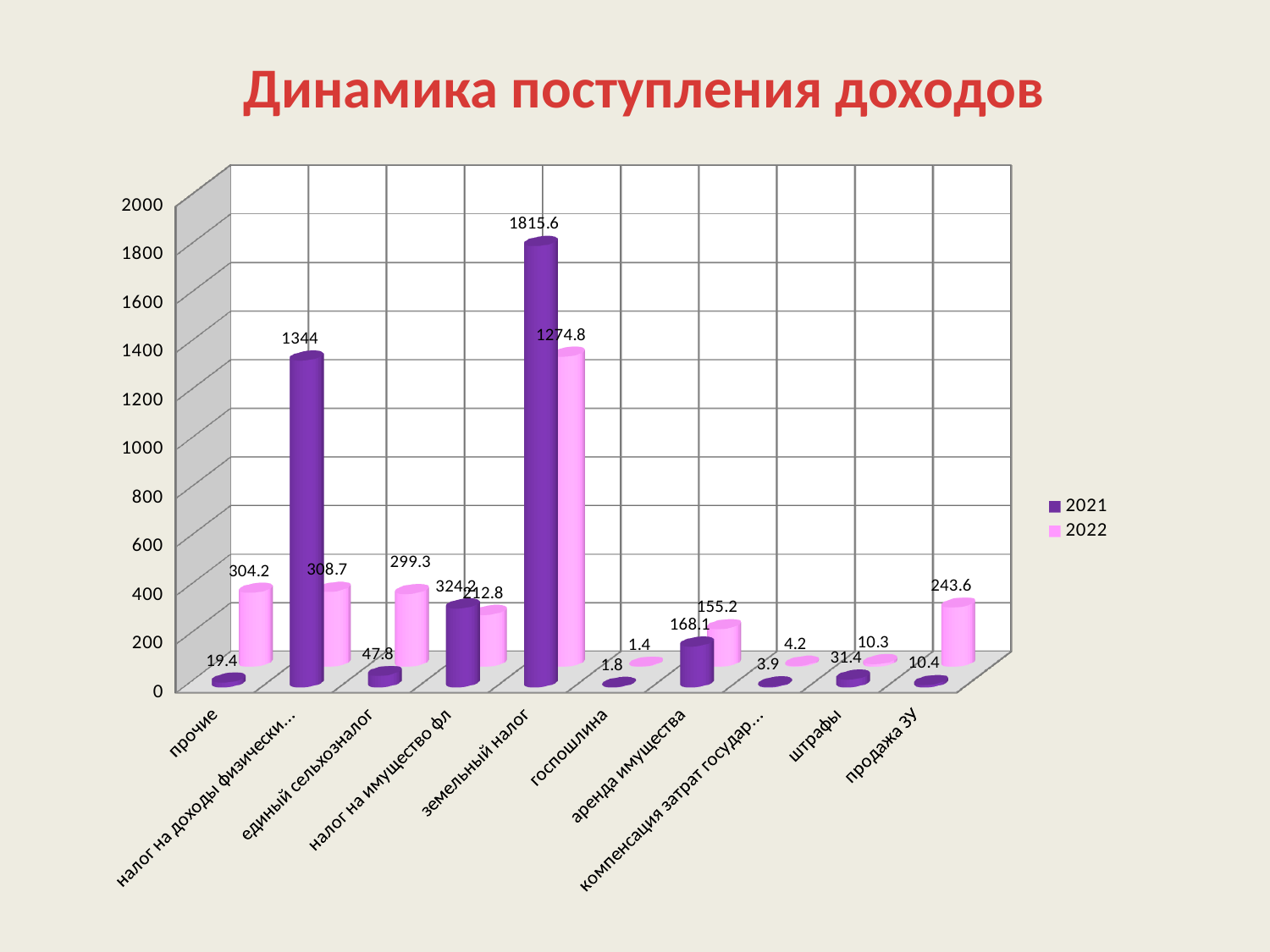
What is the title of the chart? Динамика поступления доходов What is the 2022 value for продажа ЗУ? 243.6 What is the 2021 value for земельный налог? 1815.6 How many series does the legend list? 2 What is the difference between the 2021 and 2022 values for земельный налог? 540.8 What is the difference between the 2021 and 2022 values for налог на имущество фл? 111.4 Which category has the highest 2021 value? земельный налог What is the 2021 value for штрафы? 31.4 What is the 2022 value for аренда имущества? 155.2 For прочие, which year has the larger value, 2021 or 2022? 2022 How many categories are shown on the x axis? 10 Which category has the lowest 2022 value? госпошлина